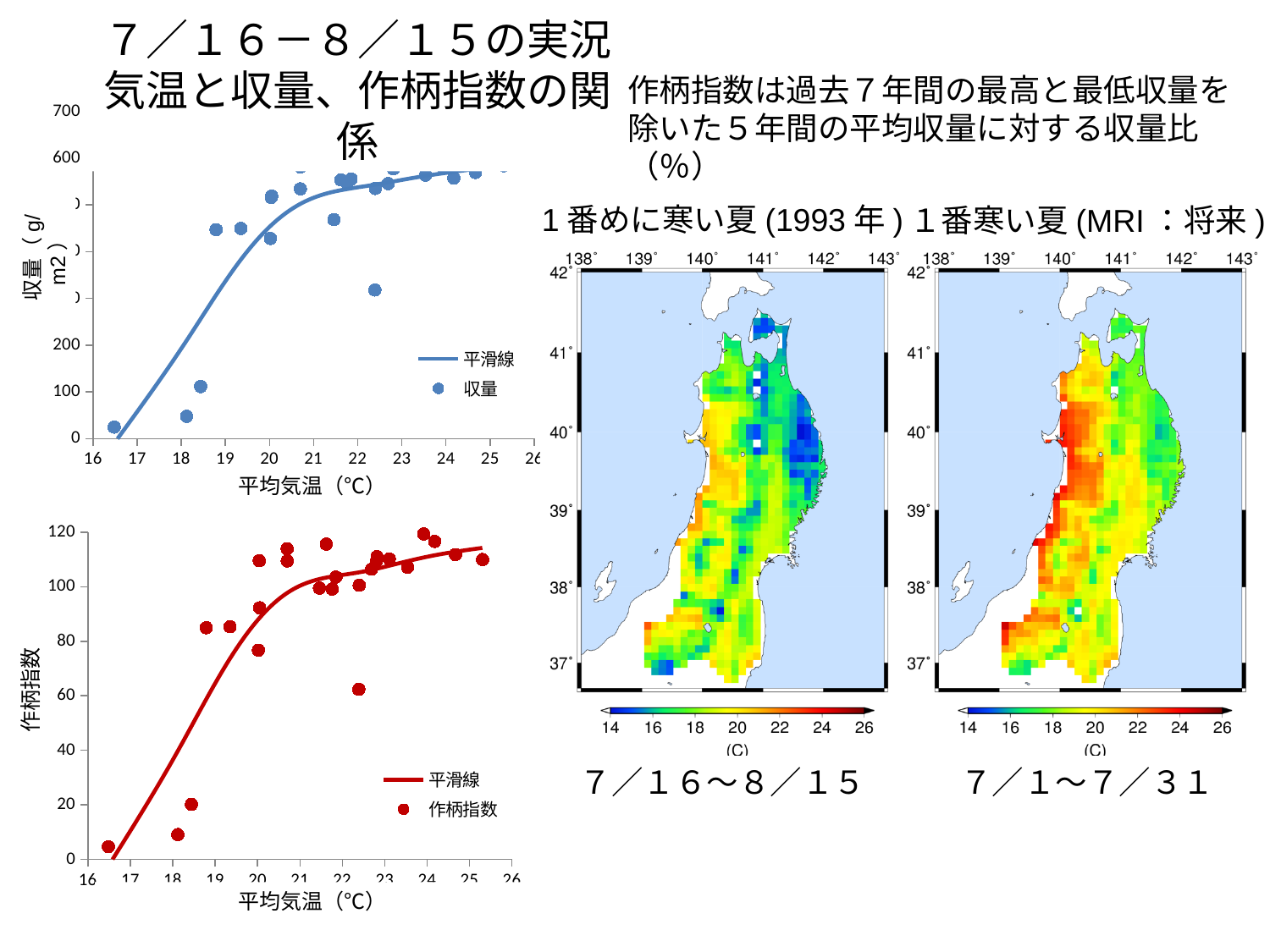
In the top-left chart, do the 収量 values generally rise or fall as 平均気温 increases? rise In the top-left chart, what is the label of the x axis? 平均気温（℃） In the bottom-left chart, is the 作柄指数 value for the point at about 16.5℃ greater or less than 20? less In the top-left chart, is the 収量 value for the point at about 16.5℃ greater or less than 100? less In the top-left chart, is the 収量 value for the lowest point near 22.4℃ greater or less than 200? greater What kind of chart is the bottom-left chart (作柄指数 vs 平均気温)? scatter chart with a smoothed line In the bottom-left chart, do the 作柄指数 values generally rise or fall as 平均気温 increases? rise In the top-left chart, how many entries does the legend list? 2 What kind of chart is the top-left chart (収量 vs 平均気温)? scatter chart with a smoothed line In the bottom-left chart, what are the two legend entries? 平滑線 and 作柄指数